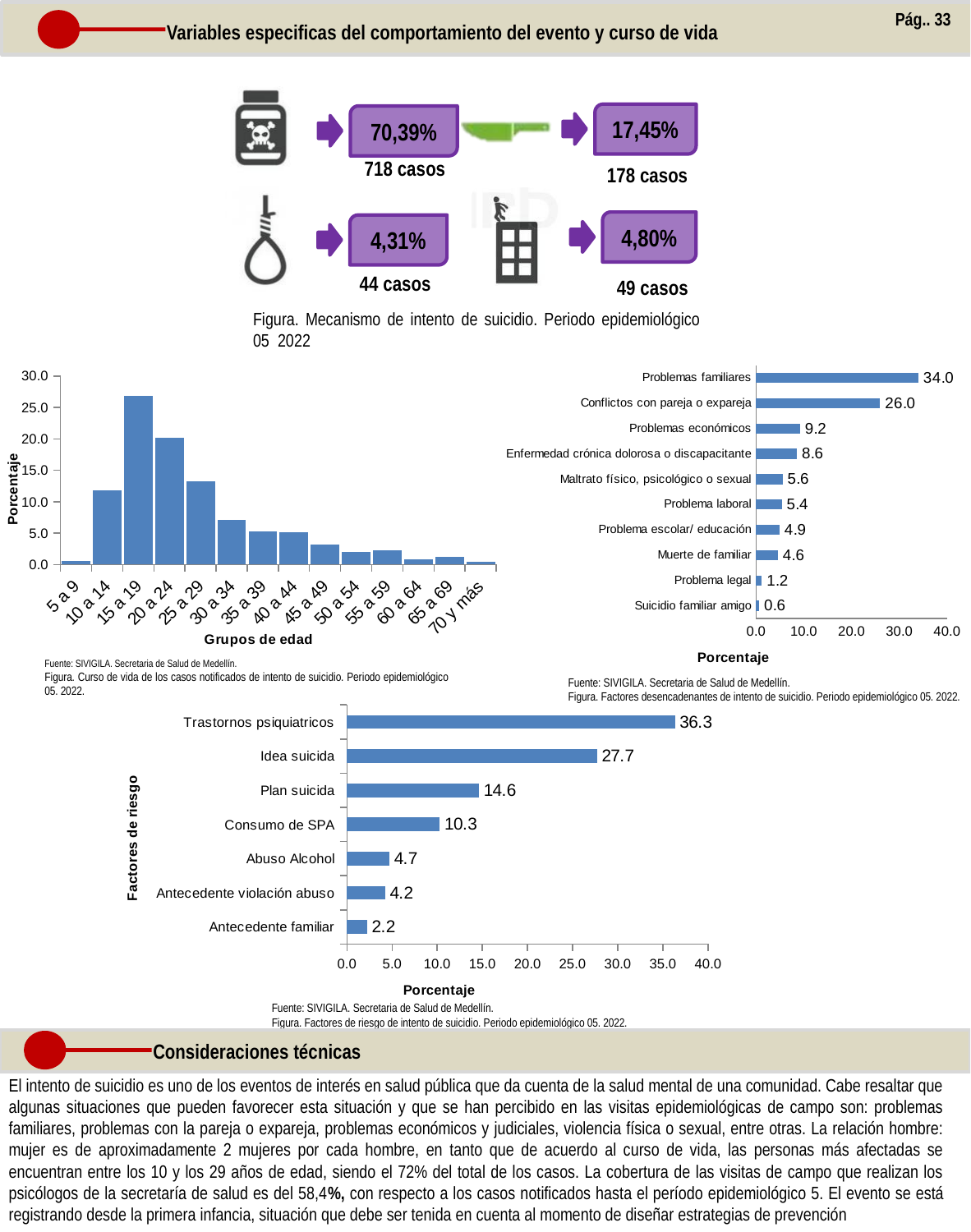
In the 'Factores de riesgo' chart (bottom of the slide), which category has the highest value? Trastornos psiquiatricos In the 'Factores de riesgo' chart (bottom of the slide), what is the value for Plan suicida? 14.6 In the 'Grupos de edad' chart (left, middle of the slide), which age group has the highest percentage? 15 a 19 In the 'Factores desencadenantes' chart (right, middle of the slide), what is the value for Problemas familiares? 34.0 In the 'Factores desencadenantes' chart (right, middle of the slide), what is the difference between Problemas familiares and Conflictos con pareja o expareja? 8.0 What kind of chart is the 'Factores de riesgo' chart at the bottom of the slide? bar chart In the 'Grupos de edad' chart (left, middle of the slide), is the value for 30 a 34 greater or less than 10.0? less In the 'Grupos de edad' chart (left, middle of the slide), how many age groups are plotted? 14 In the 'Factores de riesgo' chart (bottom of the slide), which is larger: Abuso Alcohol or Antecedente violación abuso? Abuso Alcohol In the 'Factores desencadenantes' chart (right, middle of the slide), which category has the lowest value? Suicidio familiar amigo In the 'Factores de riesgo' chart (bottom of the slide), what is the difference between Trastornos psiquiatricos and Idea suicida? 8.6 In the 'Factores desencadenantes' chart (right, middle of the slide), how many categories are plotted? 10